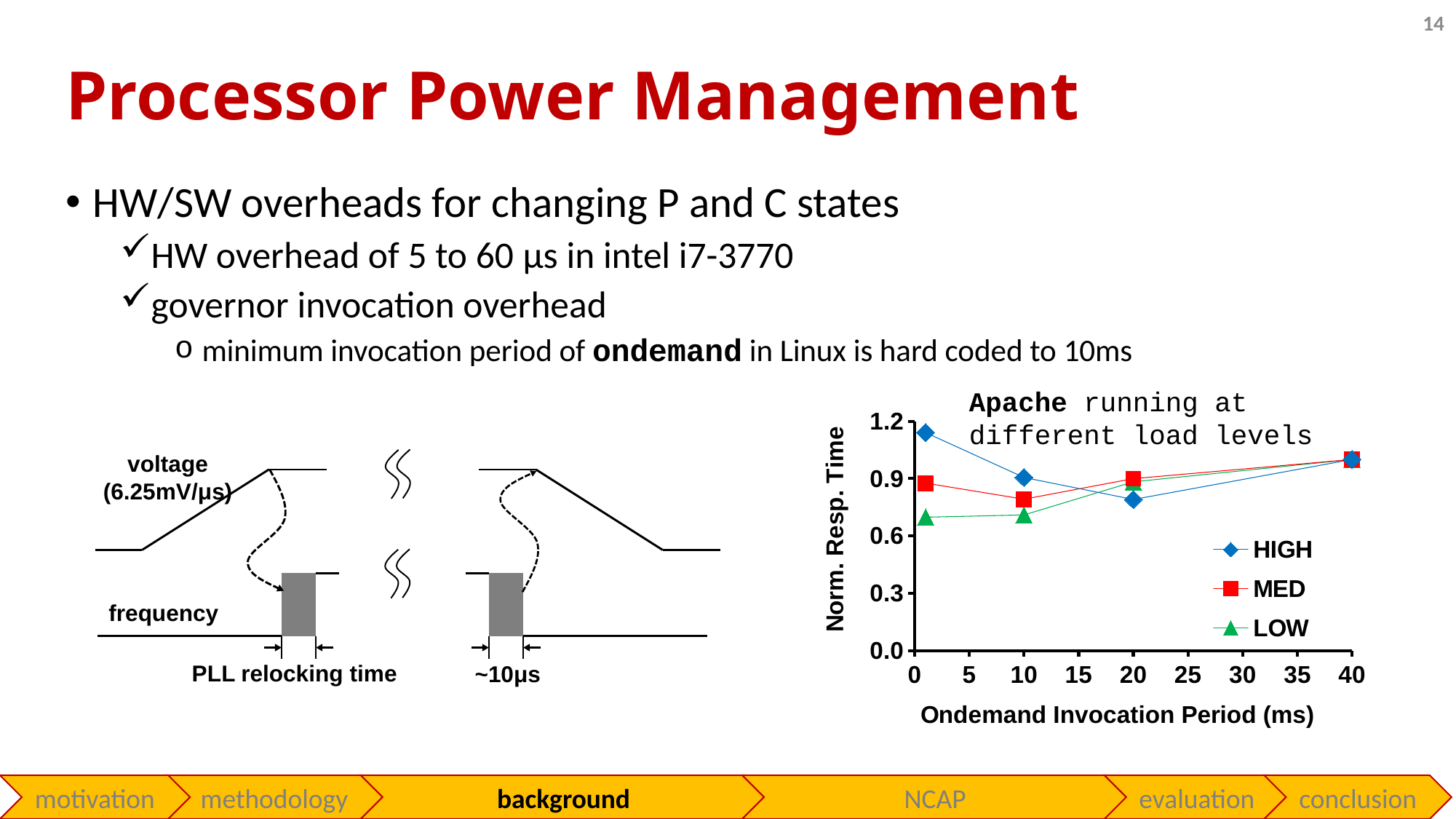
What kind of chart is the 'Apache running at different load levels' chart? line chart In the Apache chart, does the HIGH series rise or fall as the invocation period goes from 1 ms to 20 ms? fall How many series does the legend of the Apache chart list? 3 In the Apache chart, is the LOW value at an invocation period of 1 ms greater or less than 0.9? less In the Apache chart, is the HIGH value at an invocation period of 1 ms greater or less than 0.9? greater What is the x-axis title of the Apache chart? Ondemand Invocation Period (ms) How many data points are plotted for the HIGH series in the Apache chart? 4 In the Apache chart, at an invocation period of 20 ms, which is larger: the MED value or the HIGH value? MED In the Apache chart, which series has the highest normalized response time at an invocation period of 1 ms? HIGH In the Apache chart, which series has the lowest normalized response time at an invocation period of 1 ms? LOW In the Apache chart, does the LOW series rise or fall as the invocation period goes from 10 ms to 40 ms? rise In the Apache chart, is the HIGH value at an invocation period of 20 ms greater or less than 0.9? less